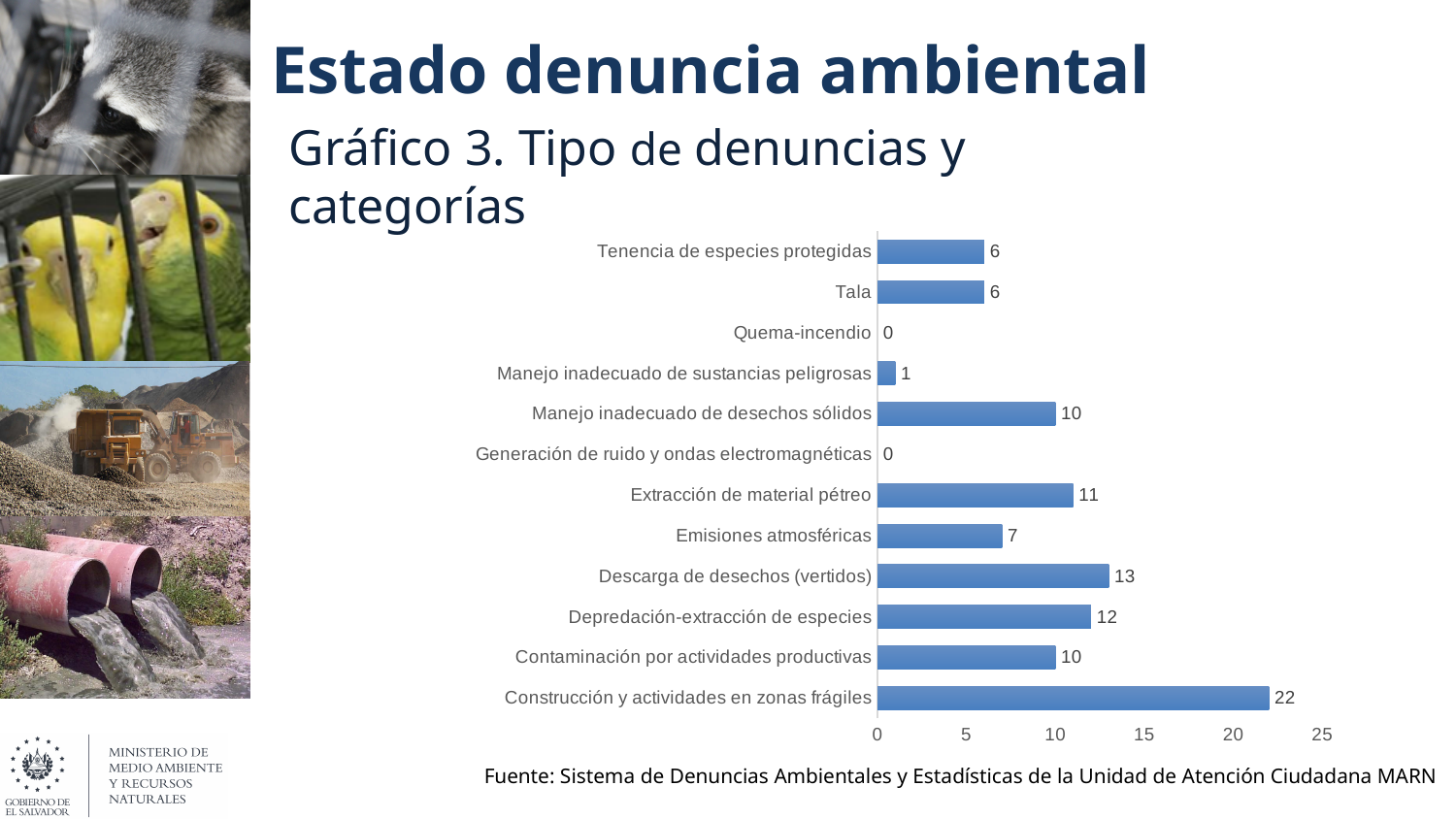
What is the difference between Construcción y actividades en zonas frágiles and Descarga de desechos (vertidos)? 9 What kind of chart is shown on the slide? Bar chart What is the value for Emisiones atmosféricas? 7 What is the value for Construcción y actividades en zonas frágiles? 22 How many categories are shown in the chart? 12 Which is larger, Extracción de material pétreo or Depredación-extracción de especies? Depredación-extracción de especies How many categories have a value of 0? 2 What is the value for Descarga de desechos (vertidos)? 13 Is the value for Construcción y actividades en zonas frágiles greater or less than 20? greater What is the value for Manejo inadecuado de sustancias peligrosas? 1 Which category has the highest value? Construcción y actividades en zonas frágiles What is the title of the chart? Gráfico 3. Tipo de denuncias y categorías